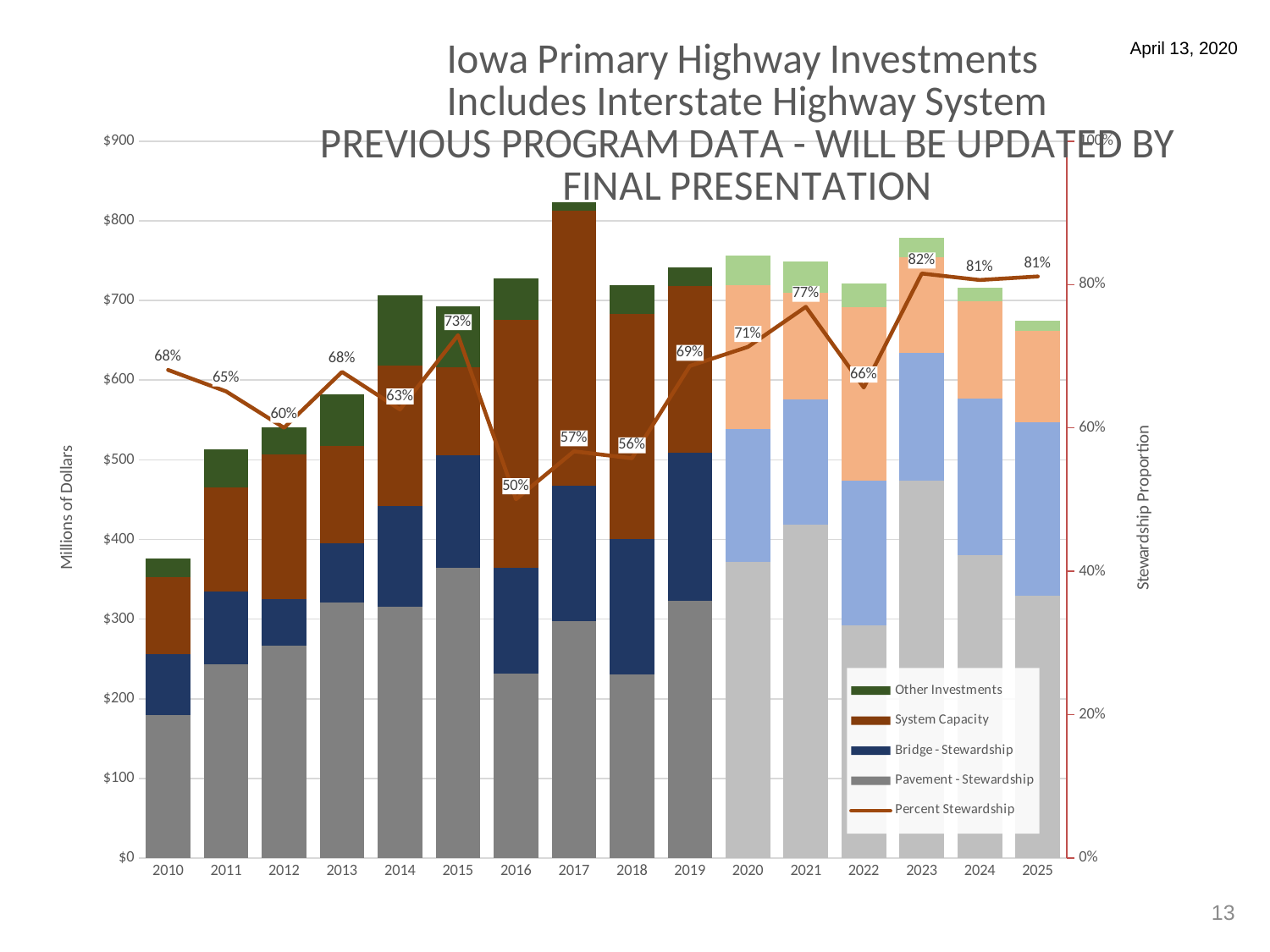
What is the Percent Stewardship value shown for 2021? 77% Which year has the lowest Percent Stewardship value? 2016 Is the total investment bar for 2010 greater or less than $400 million? less What is the Percent Stewardship value shown for 2016? 50% Do the total investment bars rise or fall from 2010 to 2014? rise What is the Percent Stewardship value shown for 2023? 82% Is the total investment bar for 2017 greater or less than $800 million? greater How many years are shown on the x axis of the chart? 16 What is the difference between the Percent Stewardship values for 2023 and 2016? 32 percentage points Which year has a higher Percent Stewardship value, 2014 or 2015? 2015 How many series does the chart's legend list? 5 Which year has the highest Percent Stewardship value? 2023